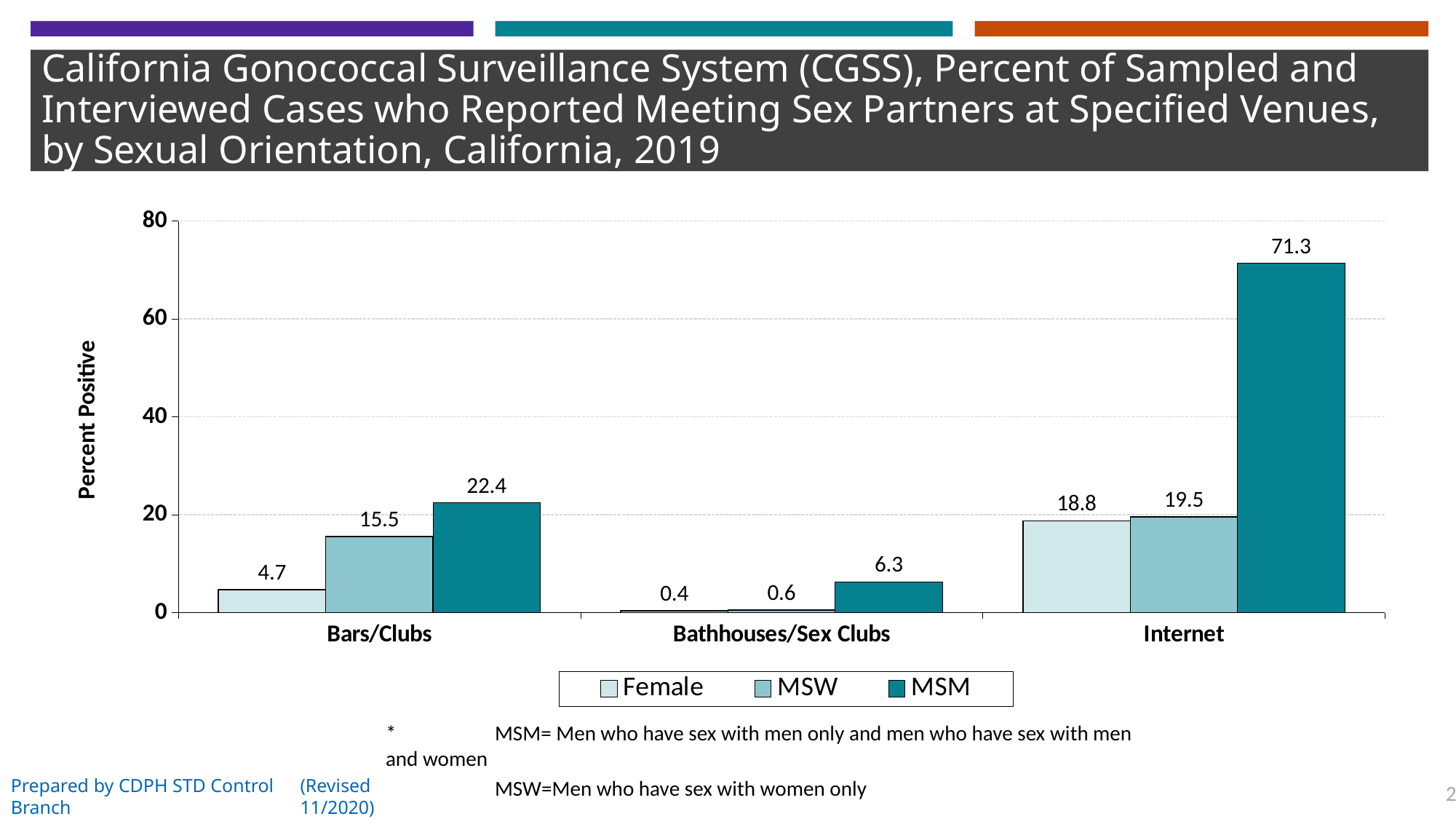
What is the value for Female at Bars/Clubs? 4.7 What kind of chart is shown on the slide? bar chart What is the label of the y axis? Percent Positive Which venue has the lowest value for Female? Bathhouses/Sex Clubs Is the value for MSM at Internet greater or less than 60? greater What is the value for MSM at Internet? 71.3 How many venue categories are shown on the x axis? 3 What is the value for MSW at Bathhouses/Sex Clubs? 0.6 What is the difference between the MSM and MSW values at Bars/Clubs? 6.9 Which venue has the highest value for MSM? Internet Which is larger at Internet, the Female value or the MSM value? MSM How many series does the legend list? 3